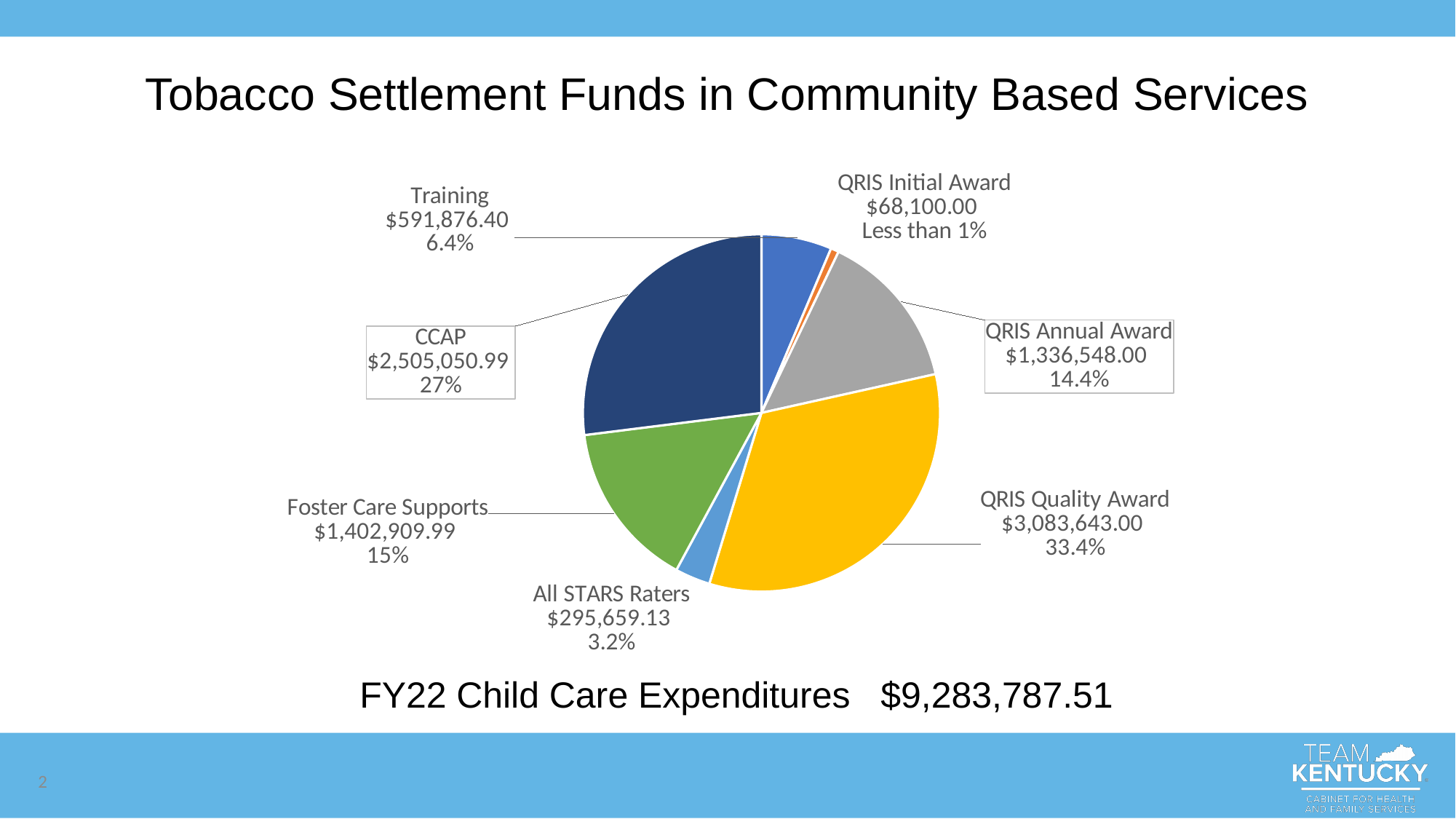
What is the difference between the QRIS Quality Award value and the CCAP value? $578,592.01 What is the dollar value for All STARS Raters? $295,659.13 What total FY22 Child Care Expenditures figure is shown below the chart? $9,283,787.51 Which category has the smallest slice of the pie? QRIS Initial Award What kind of chart is shown on the slide? pie chart What share of the pie does Foster Care Supports represent? 15% Which is larger, the value for Training or the value for All STARS Raters? Training What is the dollar value for CCAP? $2,505,050.99 What is the dollar value for QRIS Annual Award? $1,336,548.00 How many slices does the pie chart have? 7 Which category has the largest slice of the pie? QRIS Quality Award What share of the pie does QRIS Quality Award represent? 33.4%